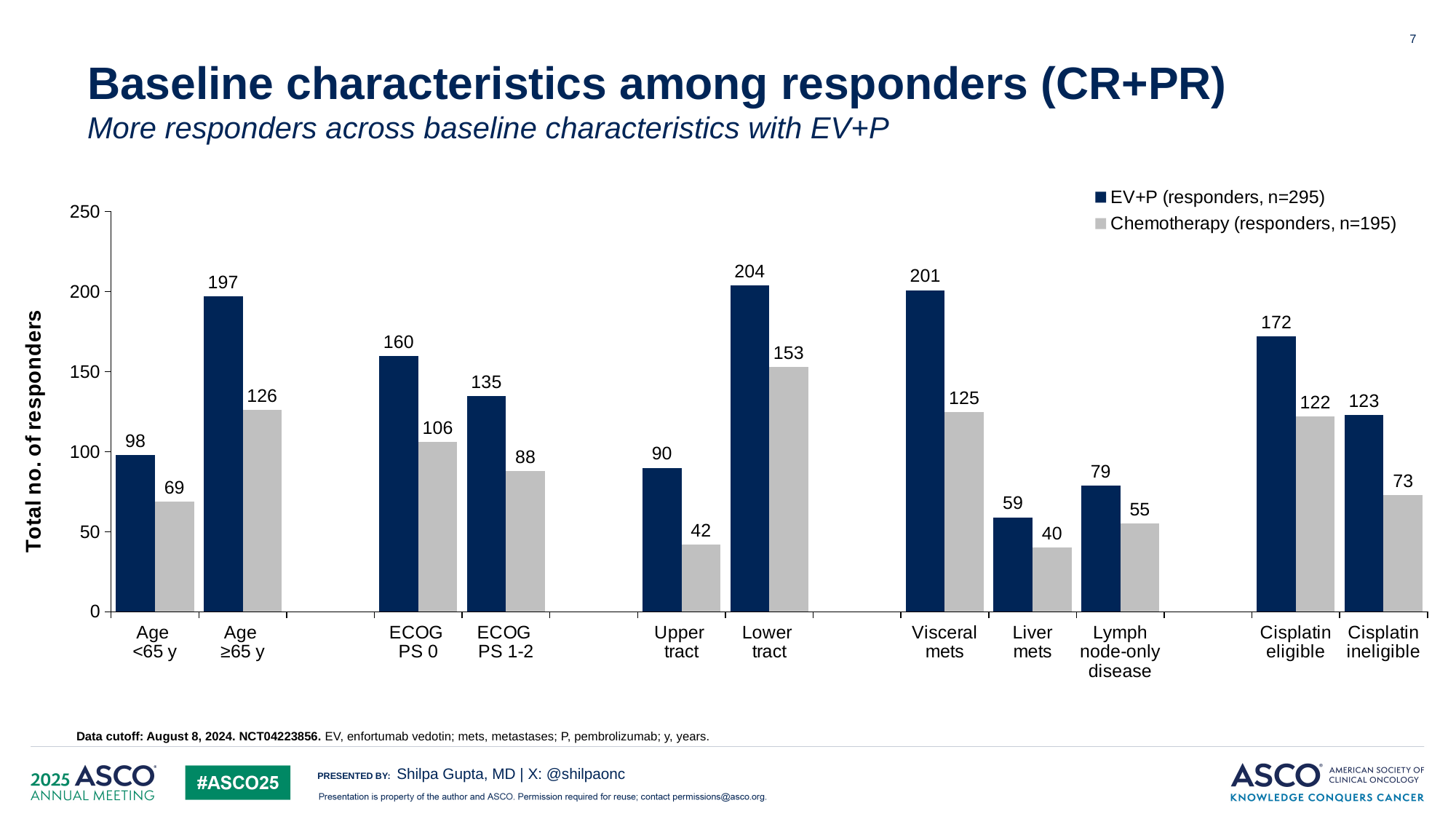
Which category has the lowest number of Chemotherapy responders? Liver mets Which is larger: the Chemotherapy value for Cisplatin eligible or the EV+P value for Cisplatin ineligible? EV+P value for Cisplatin ineligible Which category has the highest number of EV+P responders? Lower tract Is the EV+P value for ECOG PS 0 greater or less than 150? greater What is the label of the y axis? Total no. of responders What kind of chart is shown on the slide? Bar chart What is the number of EV+P responders in the Age ≥65 y category? 197 What is the number of Chemotherapy responders in the Upper tract category? 42 What is the difference between EV+P and Chemotherapy responders in the Visceral mets category? 76 How many baseline characteristic categories are shown on the x axis? 11 How many series does the legend list? 2 What is the difference between EV+P and Chemotherapy responders in the Lymph node-only disease category? 24